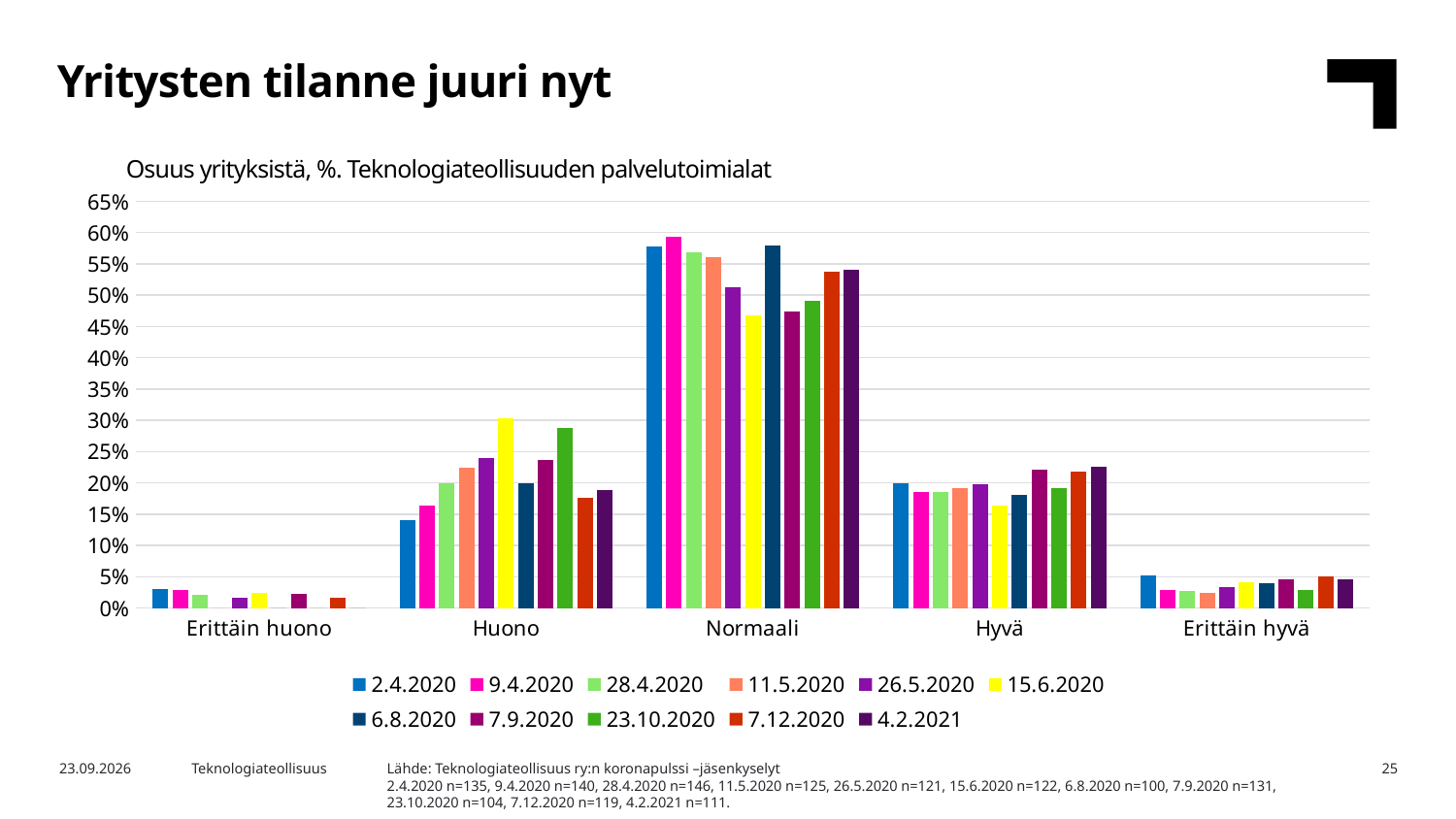
How many categories are shown on the x axis? 5 How many series does the legend list? 11 In the Huono category, which is larger: the value for 2.4.2020 or the value for 15.6.2020? 15.6.2020 Is the value for 15.6.2020 in the Normaali category greater or less than 50%? less What is the subtitle shown above the chart? Osuus yrityksistä, %. Teknologiateollisuuden palvelutoimialat In the Normaali category, which is larger: the value for 2.4.2020 or the value for 15.6.2020? 2.4.2020 Within the Huono category, which series has the highest value? 15.6.2020 What kind of chart is shown on the slide? bar chart Is the value for 15.6.2020 in the Huono category greater or less than 25%? greater Is the value for 15.6.2020 in the Hyvä category greater or less than 20%? less Which category has the highest values overall? Normaali